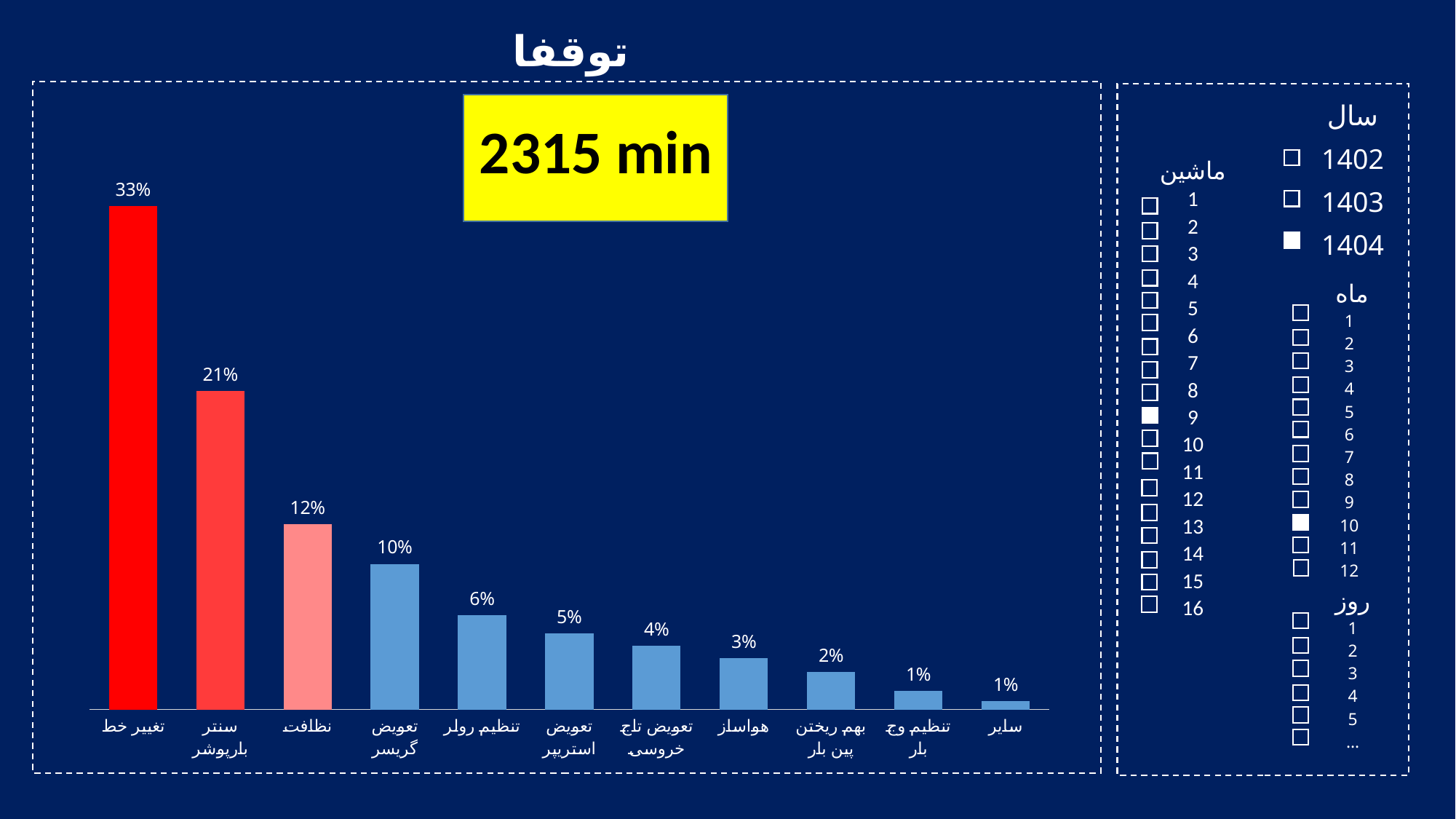
Do the values rise or fall from left to right along the x axis? fall What is the value shown for هواساز? 3% What kind of chart is shown? bar chart Which category has the highest value? تغییر خط What is the value shown for نظافت? 12% What is the value shown for تغییر خط? 33% What is the difference between the values for تغییر خط and سنتر بازپوشر? 12% What is the value shown for تعویض گریسر? 10% What is the value shown for سنتر بازپوشر? 21% Which is larger, the value for تنظیم رولر or the value for تعویض استریپر? تنظیم رولر How many categories are plotted in the chart? 11 What total number of minutes is shown in the yellow box above the chart? 2315 min